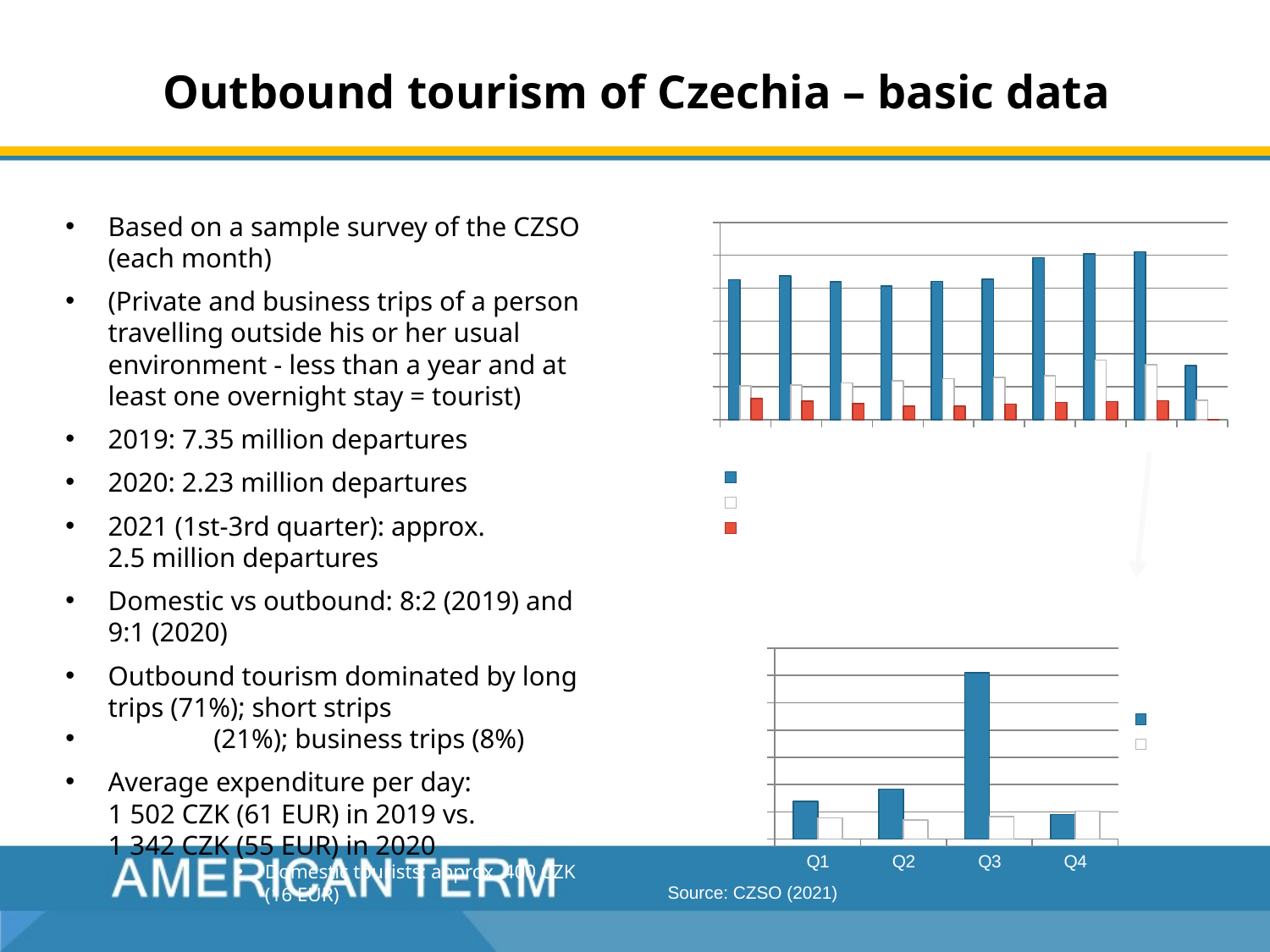
In the bottom-right chart, is the blue bar for Q2 taller or shorter than the blue bar for Q1? taller In the bottom-right chart, which quarter has the tallest blue bar? Q3 How many categories are shown on the x axis of the bottom-right chart? 4 How many groups of bars are plotted in the top-right chart? 10 What are the category labels on the x axis of the bottom-right chart? Q1, Q2, Q3, Q4 How many series does the legend of the bottom-right chart list? 2 What kind of chart is the top-right chart? bar chart What kind of chart is the bottom-right chart with categories Q1 to Q4? bar chart In the top-right chart, which colour of bar is the tallest in every group? blue In the bottom-right chart, is the blue bar for Q3 taller or shorter than the blue bar for Q1? taller How many series does the legend of the top-right chart list? 3 In the bottom-right chart, is the blue bar for Q3 taller or shorter than the white bar for Q3? taller